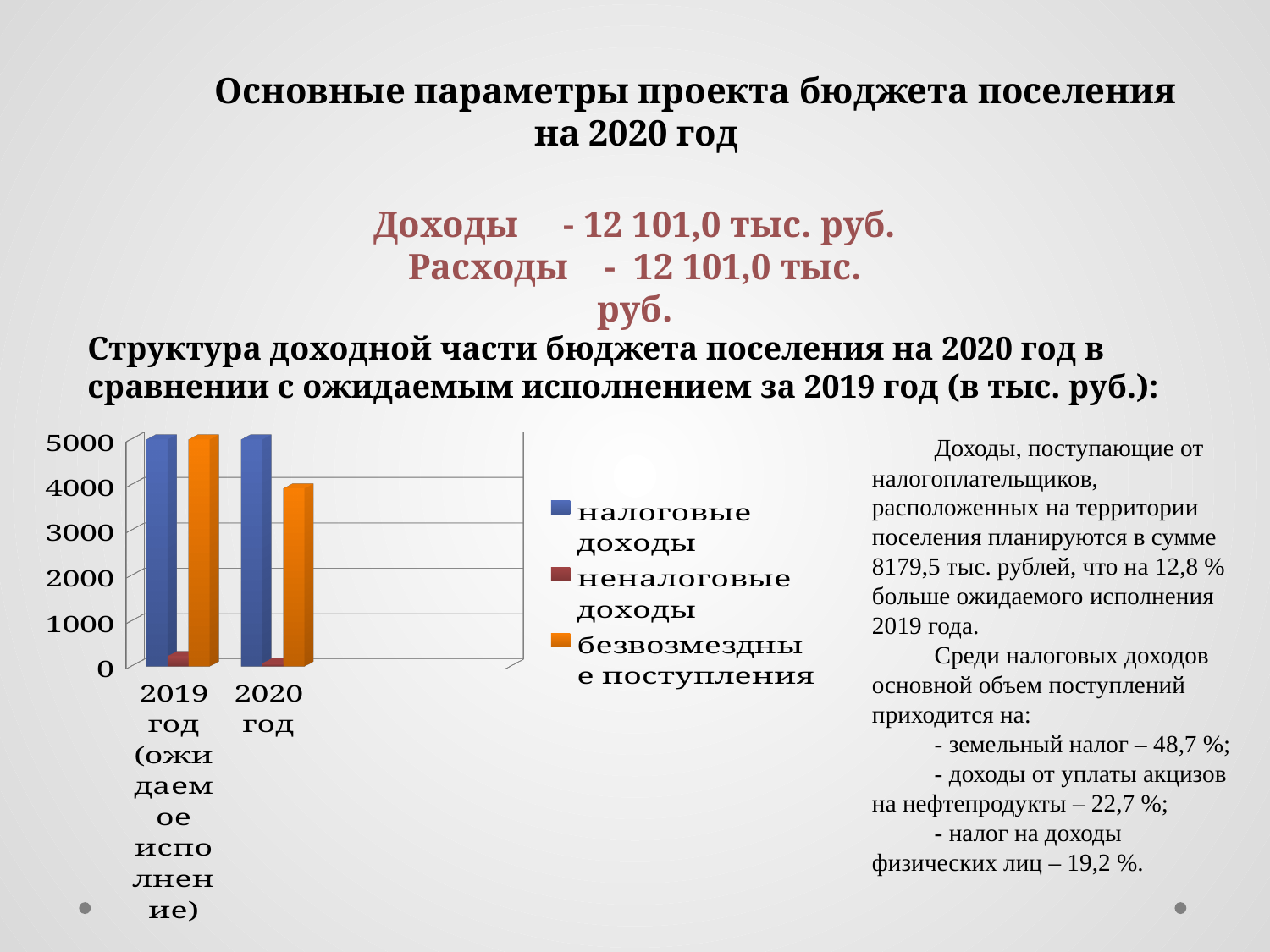
In 2020 год, which is larger: налоговые доходы or неналоговые доходы? налоговые доходы Which colour represents налоговые доходы in the chart legend? blue Which series has the lowest value in 2020 год? неналоговые доходы Is the value for налоговые доходы in 2020 год greater or less than 4000? greater How many series does the chart legend list? 3 Do the values for безвозмездные поступления rise or fall from 2019 to 2020? fall How many categories are shown on the x axis of the chart? 2 Is the value for неналоговые доходы in 2019 год (ожидаемое исполнение) greater or less than 1000? less Which is larger for безвозмездные поступления: 2019 год (ожидаемое исполнение) or 2020 год? 2019 год (ожидаемое исполнение) Is the value for безвозмездные поступления in 2020 год greater or less than 3000? greater What kind of chart is shown on the slide? bar chart